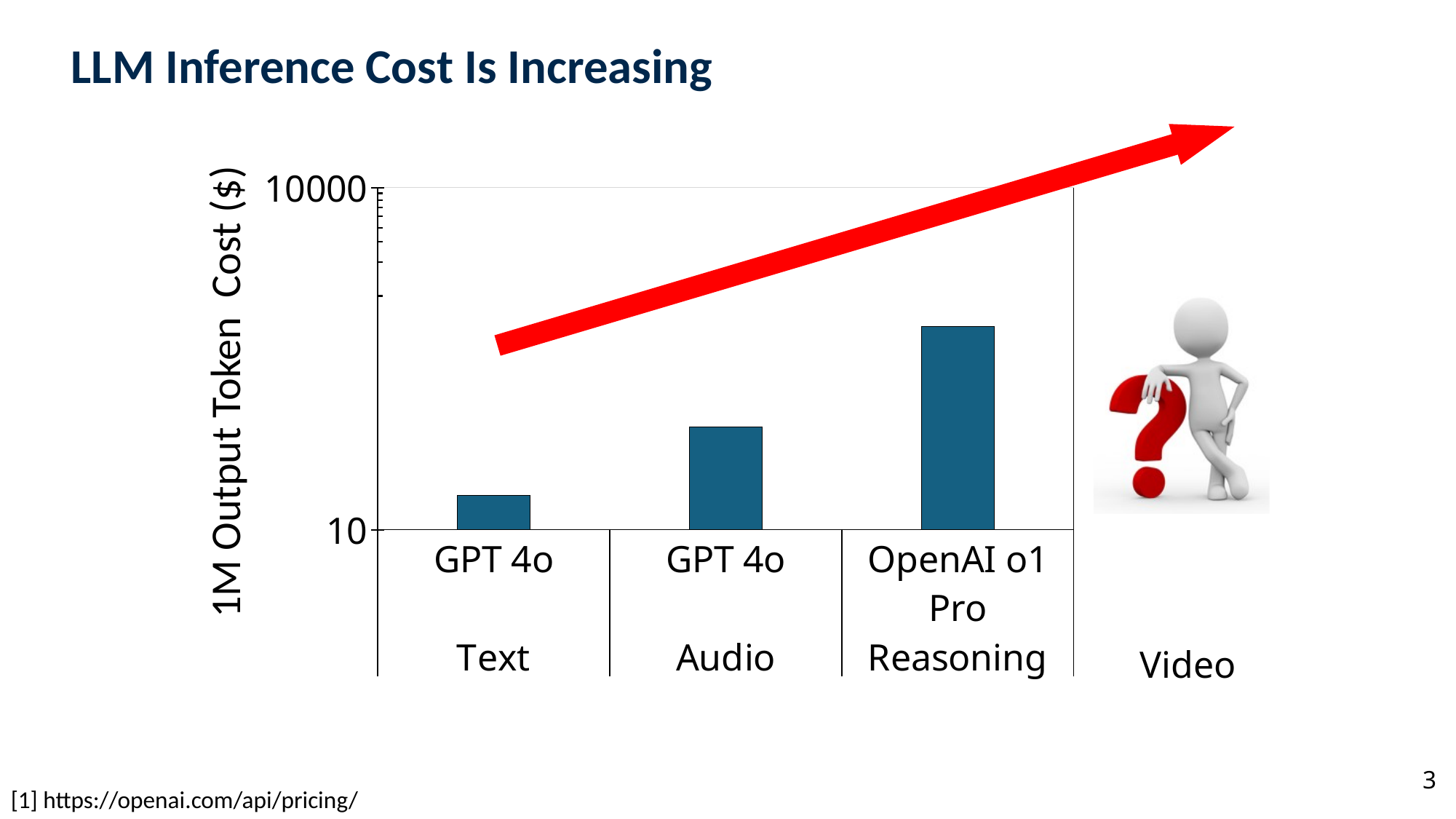
What kind of chart is shown on the slide? bar chart Do the bar values rise or fall from left to right across the categories? rise Which is larger, the bar for GPT 4o Audio or the bar for GPT 4o Text? GPT 4o Audio What is the title of the slide containing the chart? LLM Inference Cost Is Increasing Which category has the highest bar? OpenAI o1 Pro Reasoning How many bars are plotted in the chart? 3 Is the value for OpenAI o1 Pro Reasoning greater or less than 10000? less Which category has the lowest bar? GPT 4o Text Which is larger, the bar for OpenAI o1 Pro Reasoning or the bar for GPT 4o Audio? OpenAI o1 Pro Reasoning Is the value for GPT 4o Audio greater or less than 10? greater What is the label of the y-axis? 1M Output Token Cost ($) Which category on the x axis has no bar plotted? Video